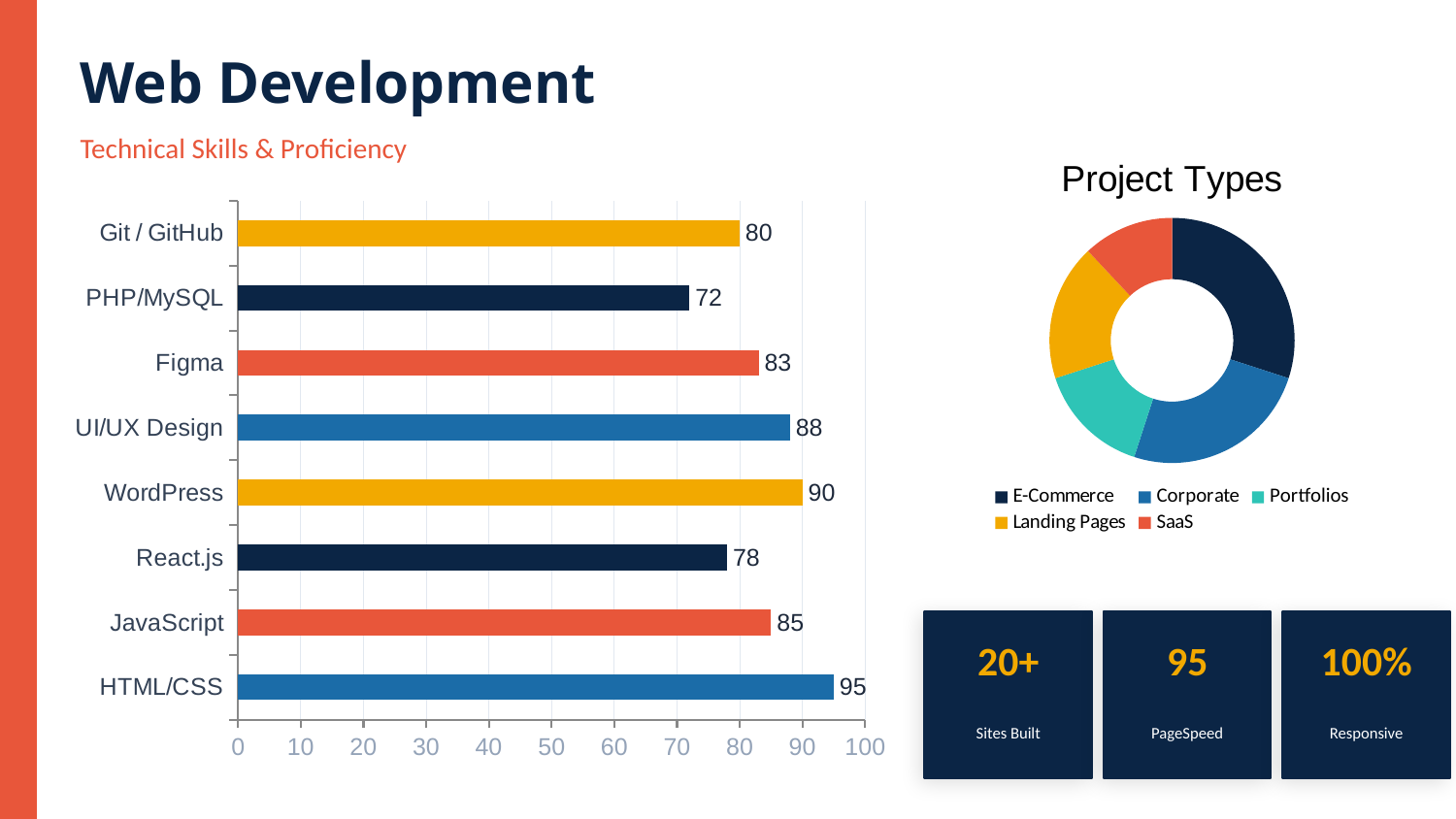
In the bar chart on the left, which skill has the lowest value? PHP/MySQL In the bar chart on the left, what is the value for HTML/CSS? 95 In the Project Types chart, which category has the largest slice? E-Commerce How many categories does the legend of the Project Types chart list? 5 In the bar chart on the left, is the value for UI/UX Design greater or less than 80? greater What kind of chart is used for the Technical Skills & Proficiency data? bar chart In the bar chart on the left, what is the value for WordPress? 90 In the bar chart on the left, what is the difference between the values for HTML/CSS and React.js? 17 In the bar chart on the left, which is larger, the value for Figma or the value for JavaScript? JavaScript In the bar chart on the left, what is the value for PHP/MySQL? 72 How many skills are shown in the bar chart on the left? 8 In the bar chart on the left, which skill has the highest value? HTML/CSS